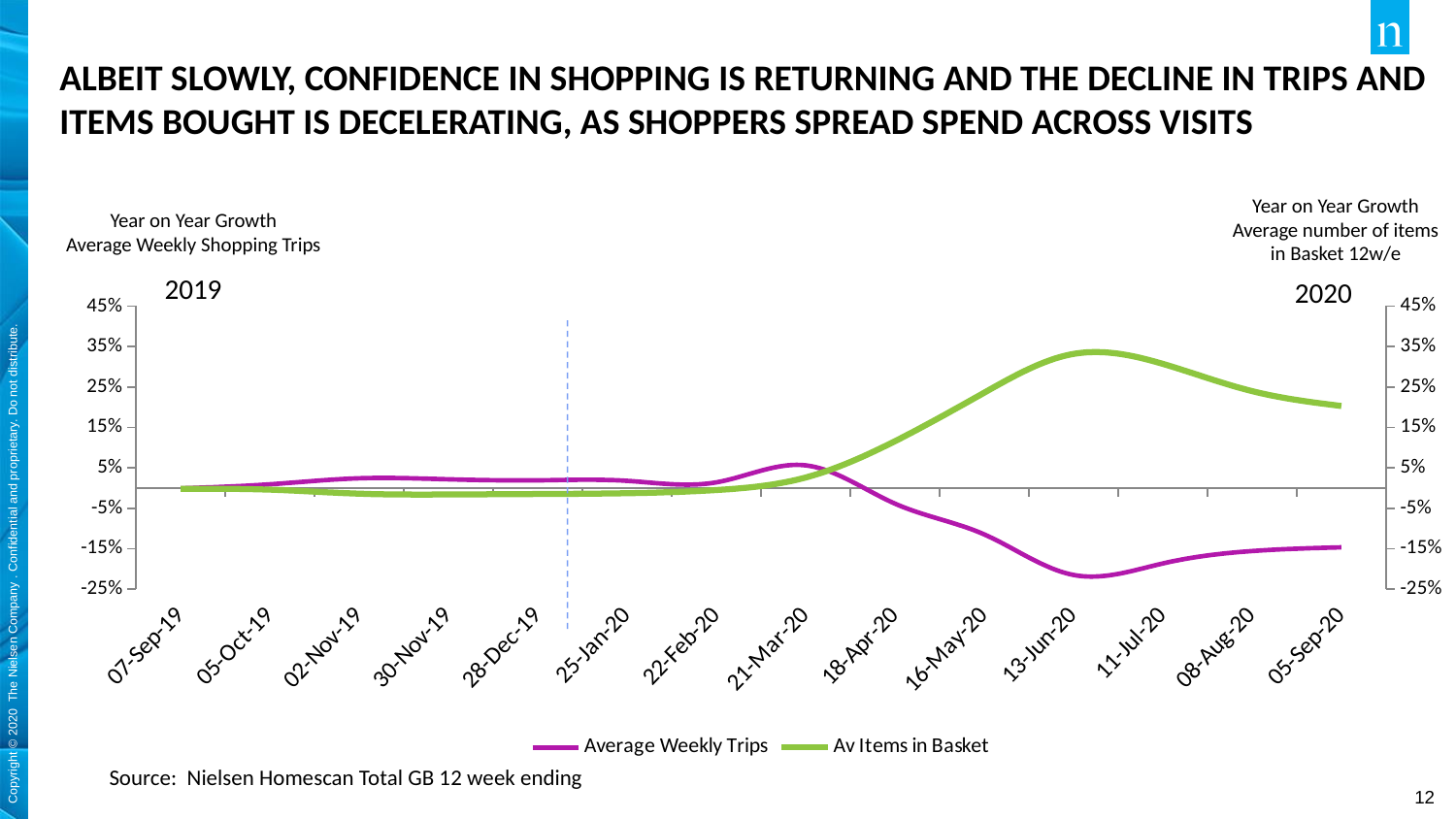
Is the value for Av Items in Basket at 05-Sep-20 greater or less than 15%? greater How many series does the legend list? 2 What kind of chart is shown on the slide? Line chart At which date does Av Items in Basket reach its highest value? 13-Jun-20 How many date labels are shown on the x axis? 14 Does the Average Weekly Trips line rise or fall between 21-Mar-20 and 13-Jun-20? Fall Does the Av Items in Basket line rise or fall between 22-Feb-20 and 13-Jun-20? Rise What are the two series named in the legend? Average Weekly Trips and Av Items in Basket Is the value for Average Weekly Trips at 05-Sep-20 greater or less than -5%? less Is the value for Av Items in Basket at 13-Jun-20 greater or less than 25%? greater At 18-Apr-20, which series has the higher value, Average Weekly Trips or Av Items in Basket? Av Items in Basket